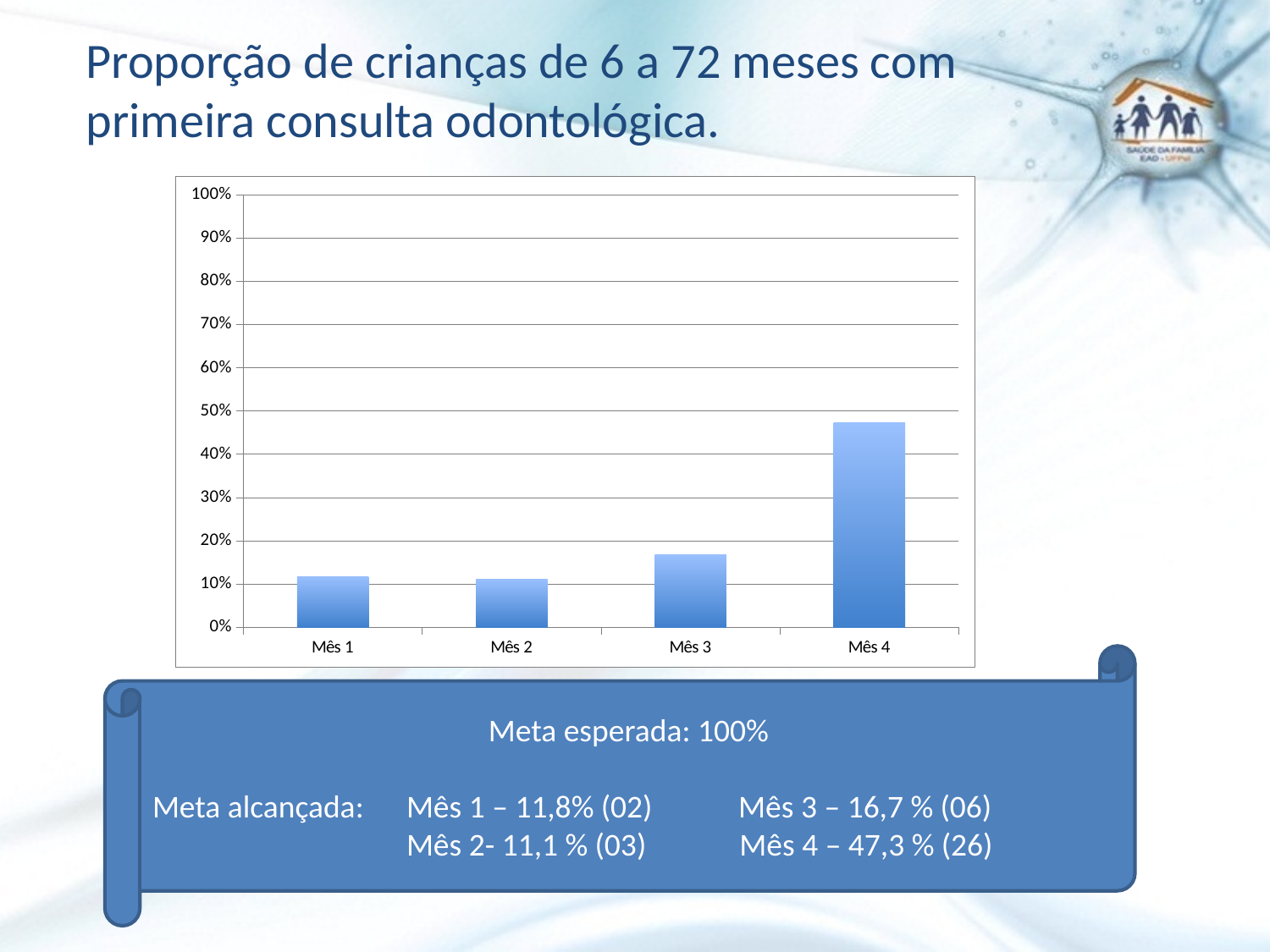
What is the maximum value shown on the y axis of the chart? 100% According to the slide, what proportion was reached in Mês 1? 11,8% Which is larger, the value for Mês 2 or the value for Mês 3? Mês 3 How many months (categories) are plotted on the x axis of the chart? 4 According to the slide, what proportion was reached in Mês 4? 47,3 % Which month has the highest proportion of children with a first dental consultation? Mês 4 Is the value for Mês 3 greater or less than 20%? less What kind of chart is shown on the slide? Bar chart Which is larger, the value for Mês 3 or the value for Mês 4? Mês 4 Is the value for Mês 4 greater or less than 40%? greater What is the expected target (meta esperada) stated on the slide? 100% Is the value for Mês 1 greater or less than 10%? greater